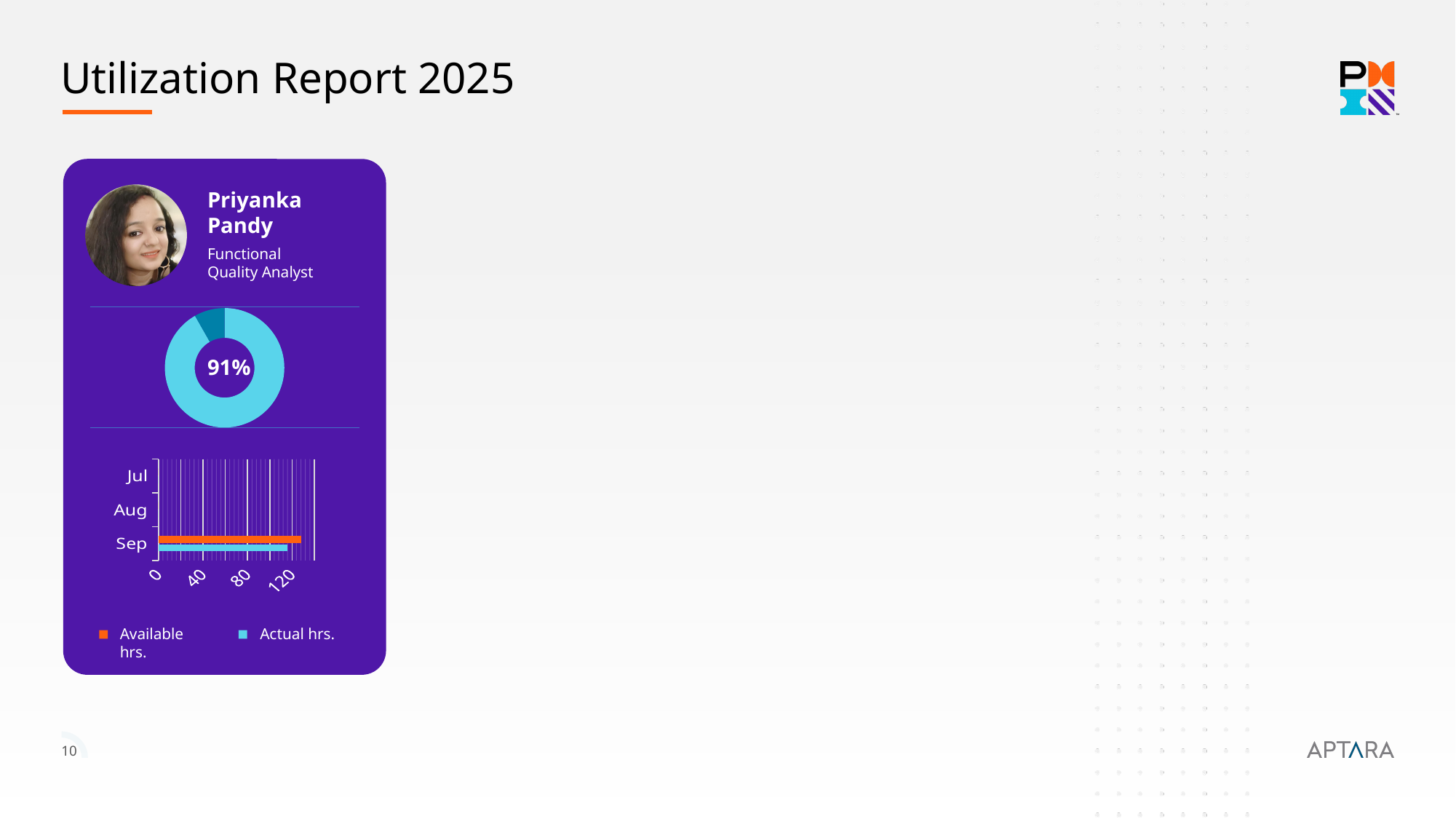
In the monthly hours bar chart, is the Actual hrs. value for Sep greater or less than 80? greater In the monthly hours bar chart, is the Available hrs. value for Sep greater or less than 120? greater How many slices does the donut chart have? 2 What kind of chart is the chart with the months Jul, Aug and Sep? bar chart In the monthly hours bar chart, which month is the only one with bars plotted? Sep What are the two series named in the legend of the monthly hours bar chart? Available hrs. and Actual hrs. How many months are listed on the axis of the monthly hours bar chart? 3 In the monthly hours bar chart, which is larger for Sep: Available hrs. or Actual hrs.? Available hrs. How many series does the legend of the monthly hours bar chart list? 2 What is the highest tick value shown on the horizontal axis of the monthly hours bar chart? 120 What percentage is shown in the centre of the donut chart? 91%